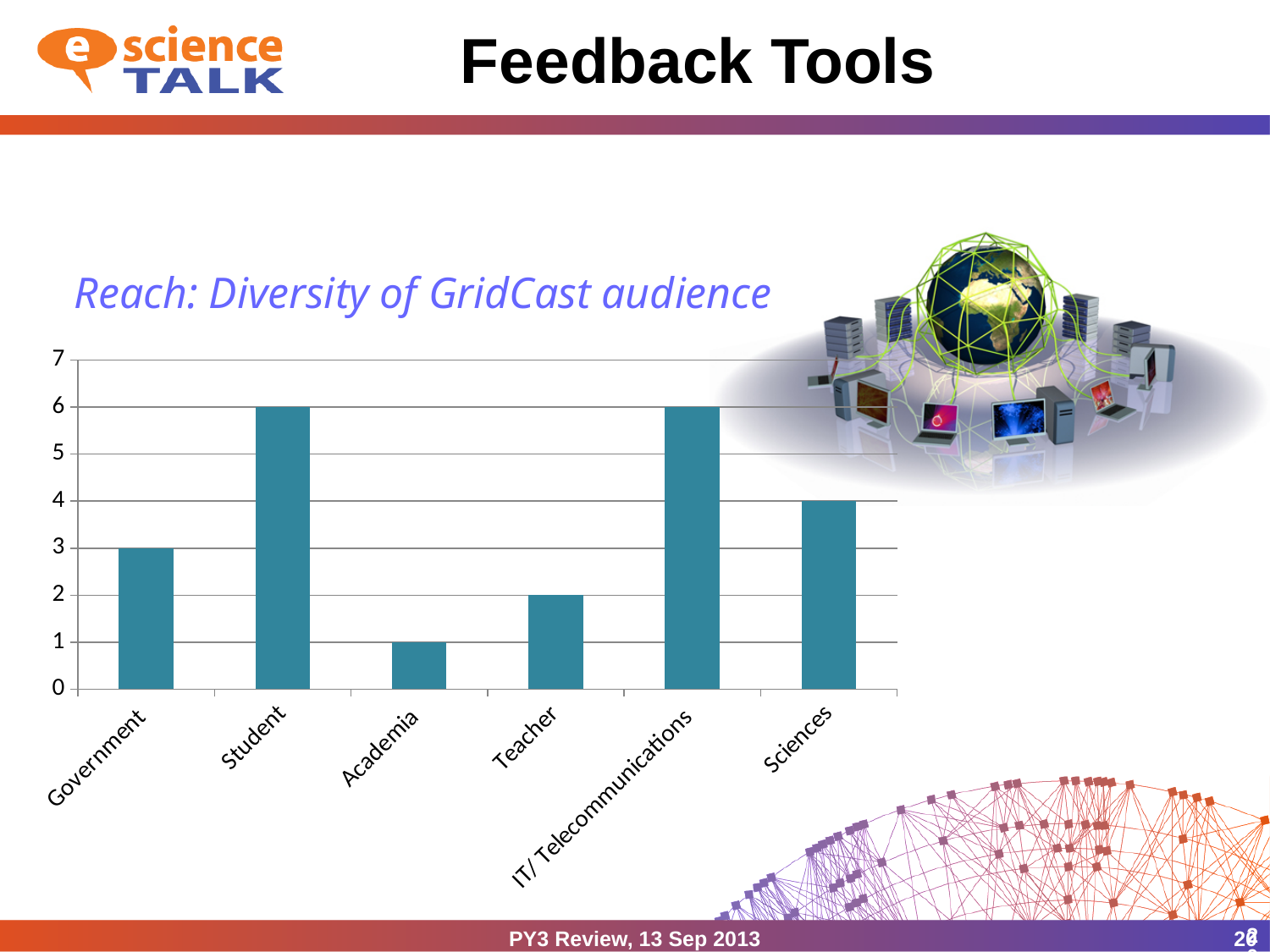
What is the value for Student? 6 What is the value for Teacher? 2 What kind of chart is shown on the slide? Bar chart How many categories are shown on the x axis? 6 What is the title of the chart? Reach: Diversity of GridCast audience Which is larger, the value for Sciences or the value for Teacher? Sciences What is the value for Academia? 1 What is the value for Sciences? 4 Is the value for IT/Telecommunications greater or less than 5? greater Which category has the lowest value? Academia What is the value for Government? 3 What is the difference between the values for Student and Government? 3